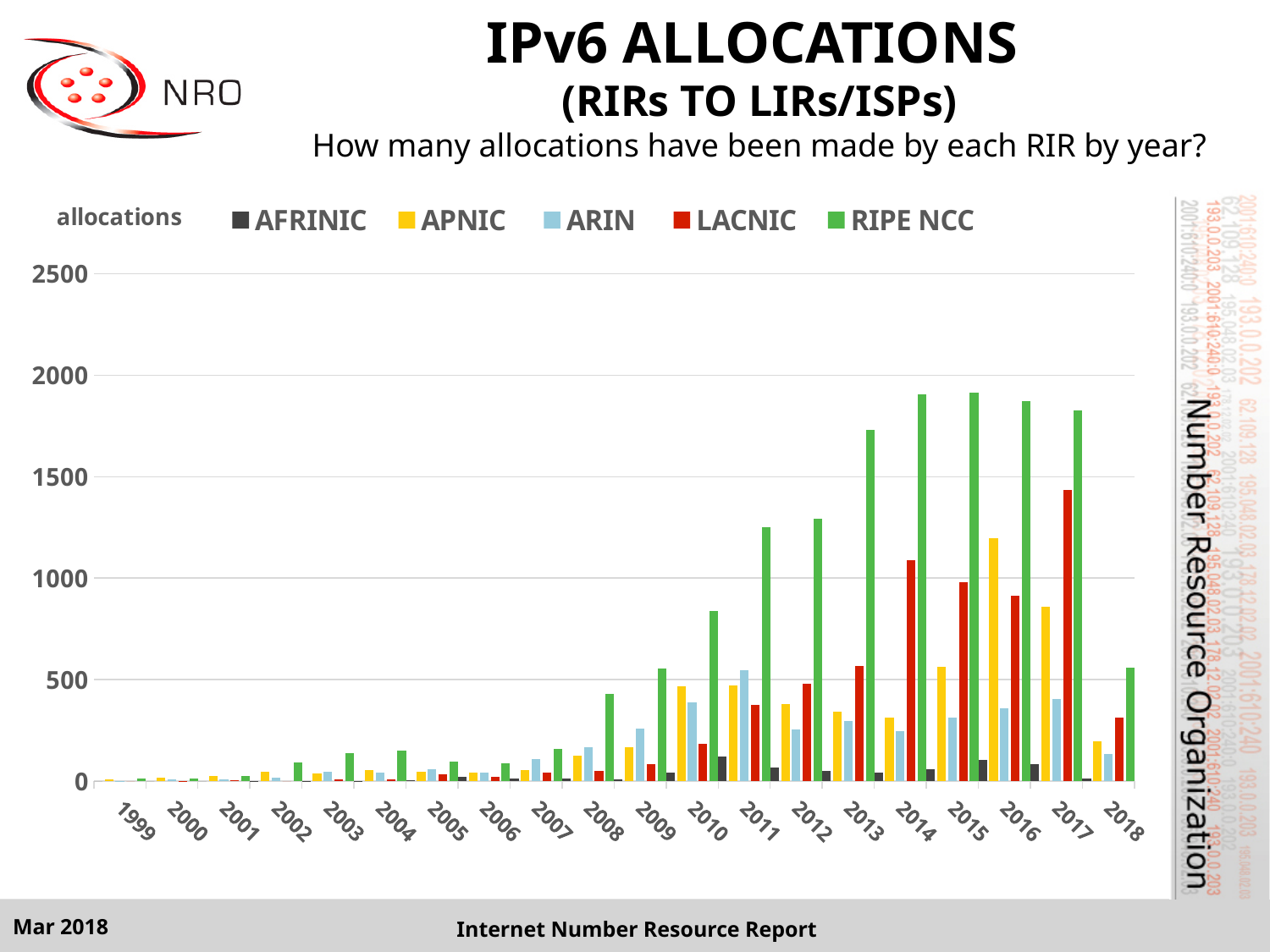
Which RIR has the highest value in 2016? RIPE NCC In 2017, which is larger: the value for LACNIC or the value for APNIC? LACNIC Which RIR has the lowest value in 2016? AFRINIC How many series does the legend list? 5 Is the value for RIPE NCC in 2015 greater or less than 1500? greater Do the values for RIPE NCC rise or fall from 2009 to 2014? rise Is the value for ARIN in 2011 greater or less than 1000? less Is the value for APNIC in 2016 greater or less than 1000? greater What kind of chart is shown on the slide? bar chart In 2014, which is larger: the value for RIPE NCC or the value for LACNIC? RIPE NCC How many years are shown along the x axis? 20